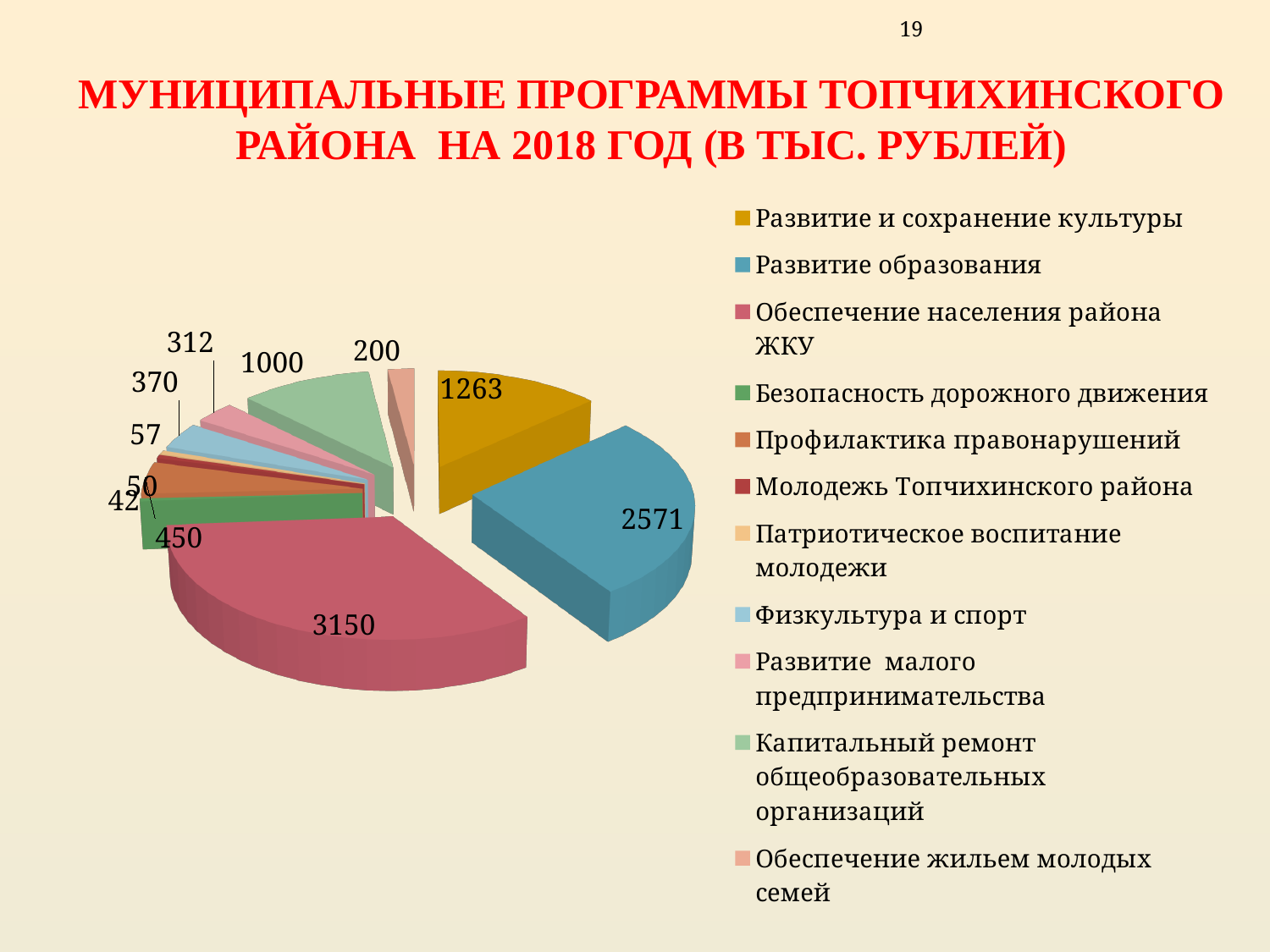
How many slices does the pie chart have? 11 What is the value for Безопасность дорожного движения? 42 What is the value for Развитие образования? 2571 What is the difference between the values for Развитие и сохранение культуры and Капитальный ремонт общеобразовательных организаций? 263 Which is larger: Физкультура и спорт or Развитие малого предпринимательства? Физкультура и спорт What is the value for Развитие и сохранение культуры? 1263 What is the value for Обеспечение населения района ЖКУ? 3150 What is the difference between the values for Обеспечение населения района ЖКУ and Развитие образования? 579 Which program has the largest slice of the pie? Обеспечение населения района ЖКУ What kind of chart is shown on the slide? Pie chart What is the title of the slide? МУНИЦИПАЛЬНЫЕ ПРОГРАММЫ ТОПЧИХИНСКОГО РАЙОНА НА 2018 ГОД (В ТЫС. РУБЛЕЙ) What is the value for Капитальный ремонт общеобразовательных организаций? 1000